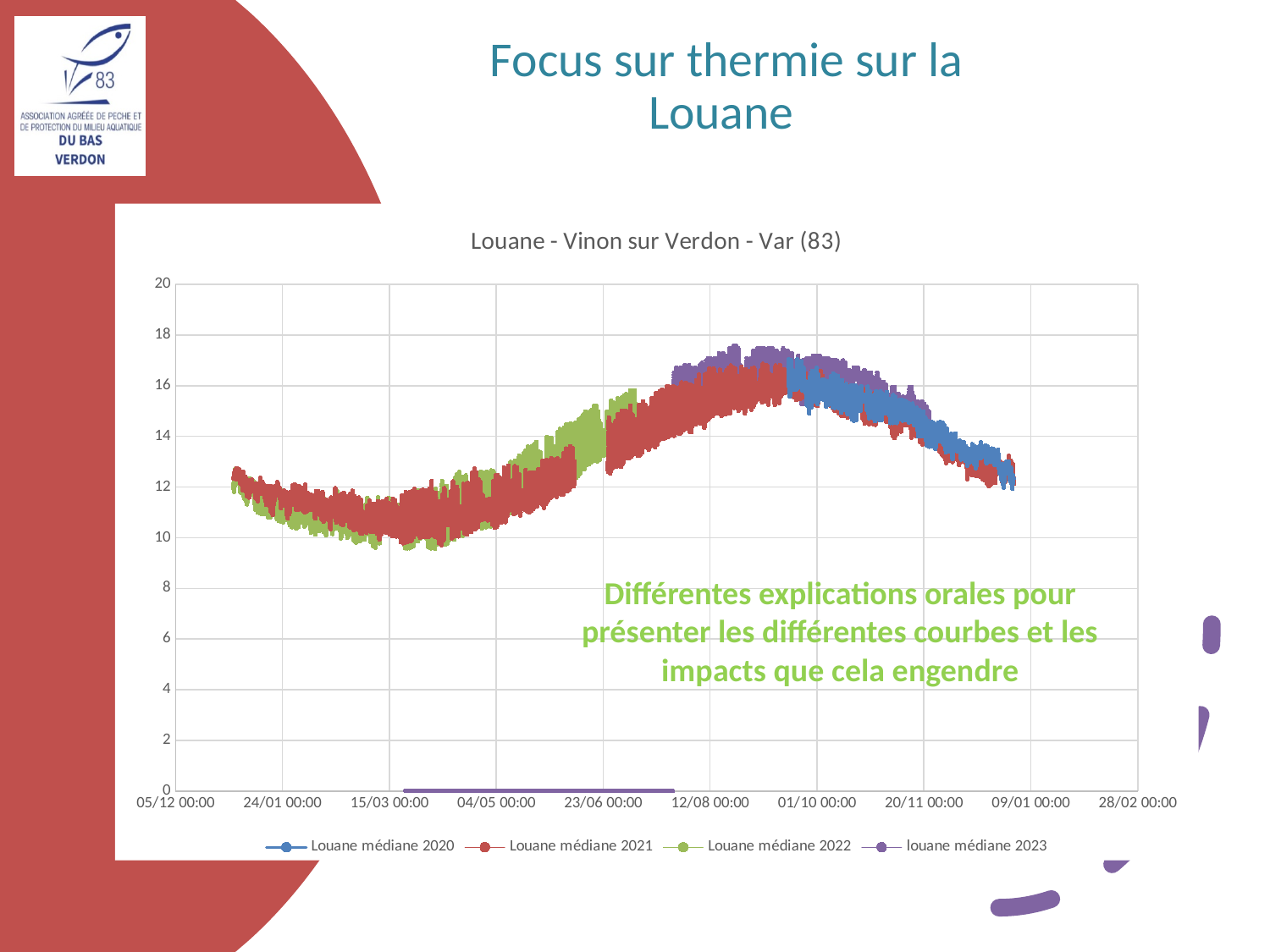
What is the highest value shown on the vertical axis? 20 Is the value for Louane médiane 2021 around 12/08 00:00 greater or less than 14? greater Do the values of Louane médiane 2021 rise or fall between 15/03 00:00 and 12/08 00:00? rise How many date labels are shown on the horizontal axis? 10 Do the values of Louane médiane 2020 rise or fall between 01/10 00:00 and 09/01 00:00? fall Is the value for Louane médiane 2020 around 09/01 00:00 greater or less than 16? less Is the value for Louane médiane 2022 around 15/03 00:00 greater or less than 12? less Which colour is used for the series 'Louane médiane 2022'? green How many series does the legend list? 4 What kind of chart is shown on the slide? line chart What is the title of the chart? Louane - Vinon sur Verdon - Var (83)